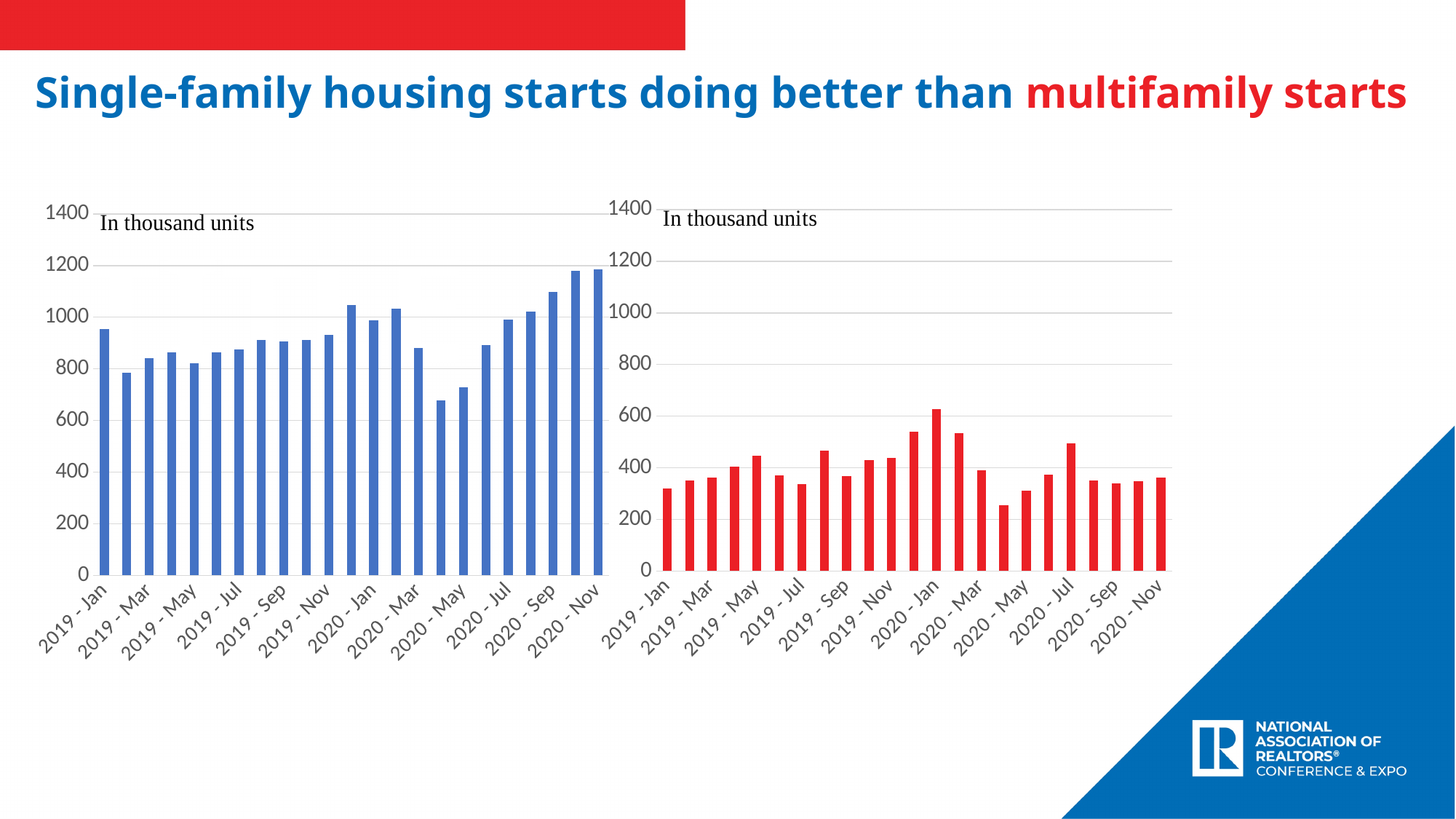
On the right chart, is the value for 2020 - Jan greater or less than 500? greater On the right chart, do the values rise or fall from 2020 - Jan to 2020 - Apr? fall On the right chart, which month has the highest value? 2020 - Jan On the left chart, do the values rise or fall from 2020 - Apr to 2020 - Nov? rise On the left chart, is the value for 2020 - Nov greater or less than 1000? greater On the left chart, is the value for 2020 - Apr greater or less than 800? less On the right chart, which month has the lowest value? 2020 - Apr What unit label is shown on both charts? In thousand units On the left chart, which month has the lowest value? 2020 - Apr What kind of chart is the left chart on the slide? bar chart On the left chart, which is larger, the value for 2019 - Jan or 2019 - Feb? 2019 - Jan